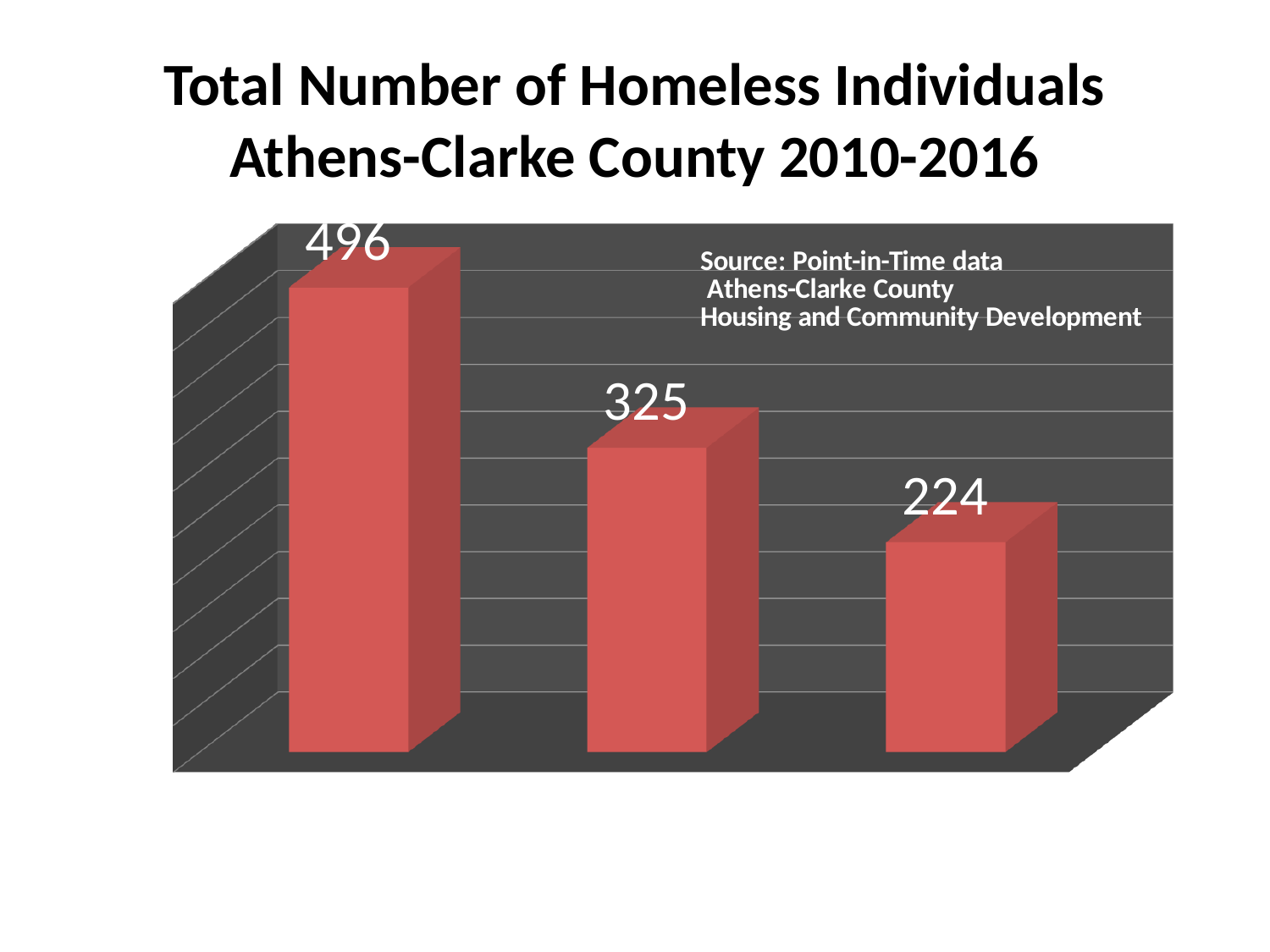
What kind of chart is shown on the slide? bar chart What is the difference between the leftmost bar's value and the middle bar's value? 171 Which is larger, the middle bar's value or the rightmost bar's value? the middle bar's value What is the value shown on the leftmost bar? 496 What is the difference between the leftmost bar's value and the rightmost bar's value? 272 Do the bar values rise or fall from left to right? fall Which bar has the lowest value: the leftmost, middle, or rightmost? rightmost How many bars are plotted in the chart? 3 Which bar has the highest value: the leftmost, middle, or rightmost? leftmost What is the value shown on the middle bar? 325 What is the title of the chart? Total Number of Homeless Individuals Athens-Clarke County 2010-2016 What is the value shown on the rightmost bar? 224